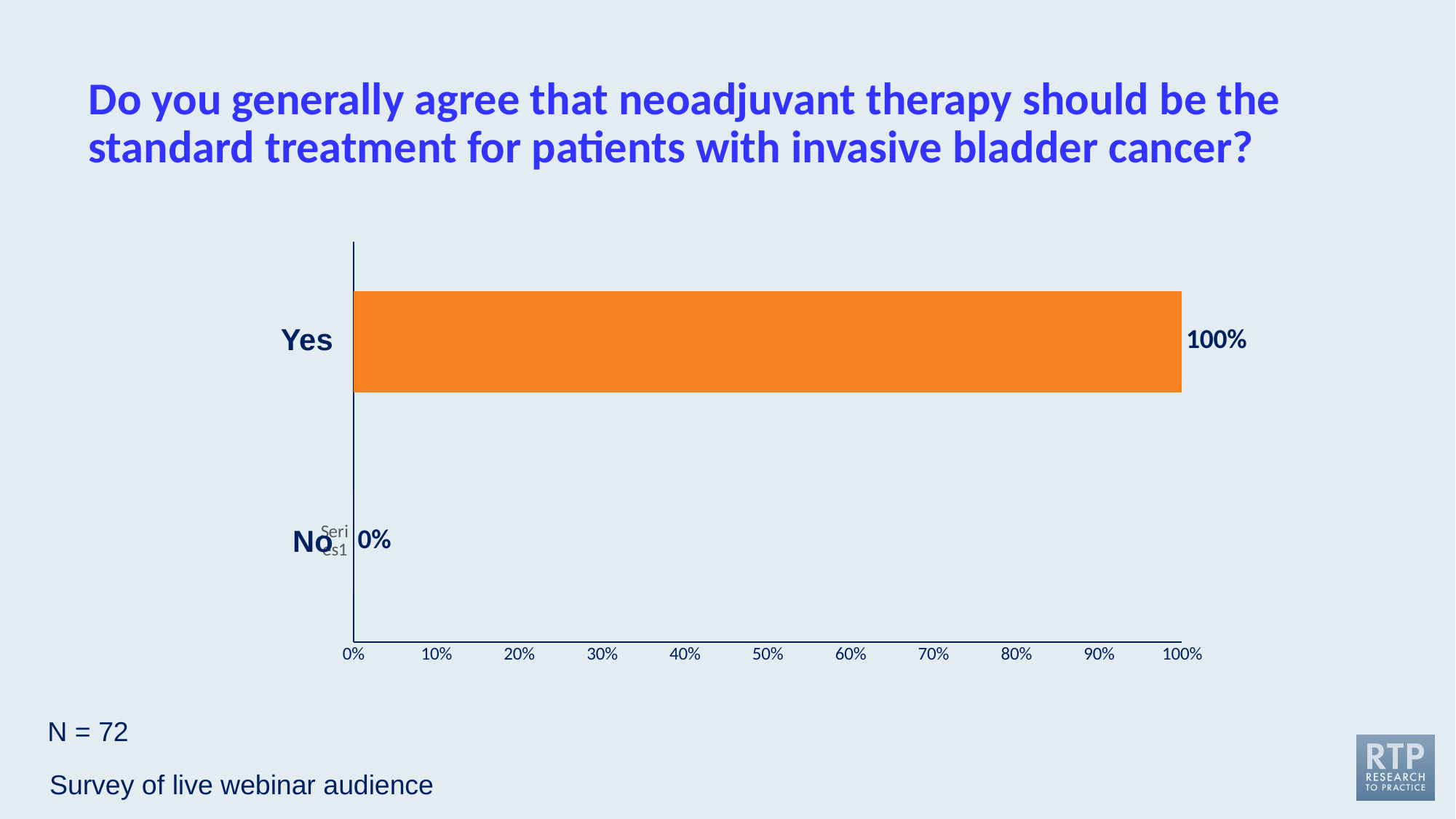
Which response category has the lowest value? No Is the value for Yes greater or less than 50%? greater What is the sample size (N) stated on the slide? 72 Which response category has the highest value? Yes Which is larger, the value for Yes or the value for No? Yes What is the total of the Yes and No percentages? 100% What percentage of respondents answered No? 0% What is the difference between the Yes and No percentages? 100% What percentage of respondents answered Yes? 100% What kind of chart is shown on the slide? Bar chart What colour is the bar for Yes? Orange How many response categories are shown in the chart? 2